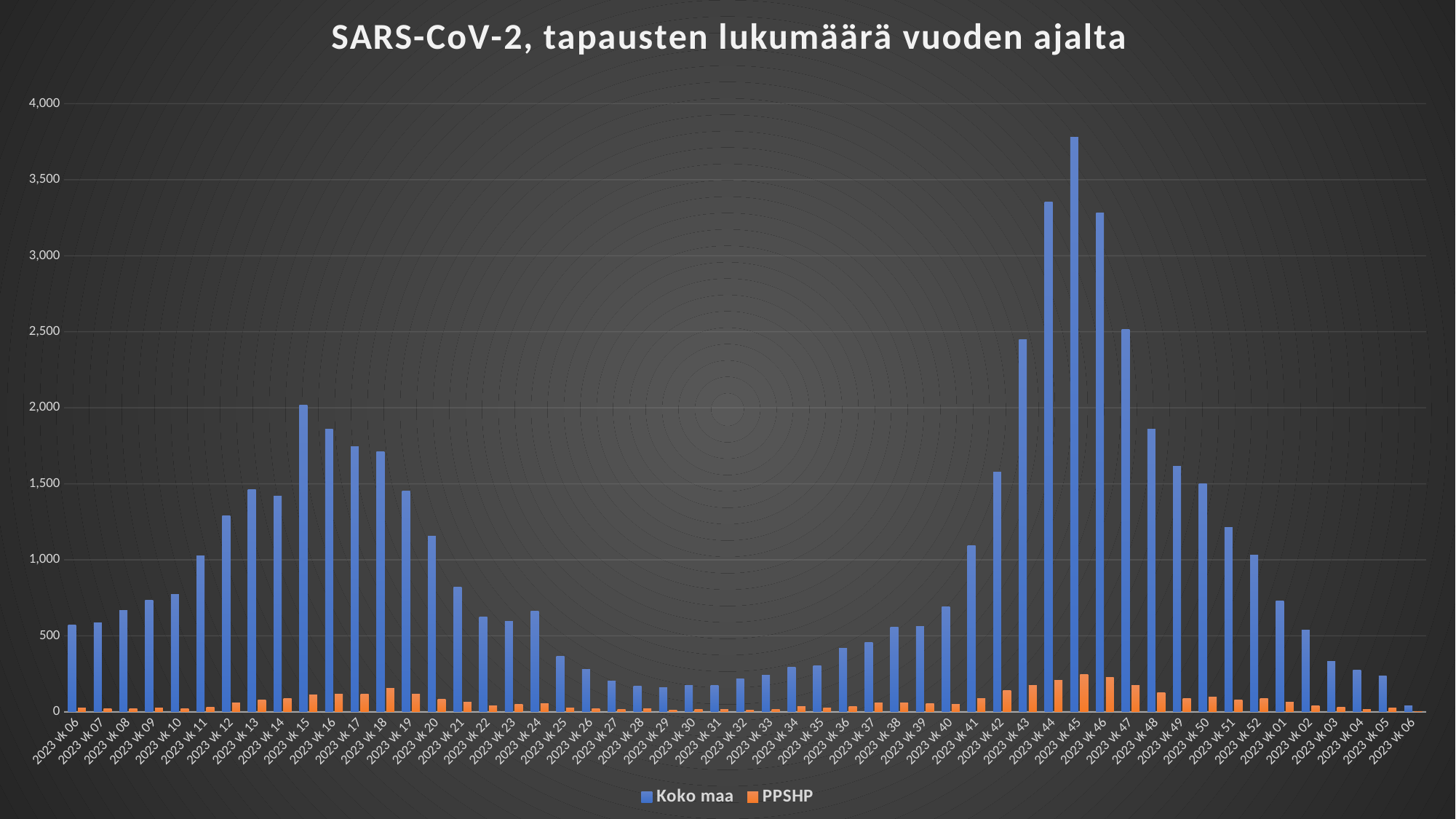
How many series does the legend list? 2 Which week has the highest value for Koko maa? 2023 vk 45 Do the Koko maa values rise or fall from 2023 vk 45 to the last week on the x axis? fall Is the Koko maa value for 2023 vk 48 greater or less than 1,500? greater Is the Koko maa value for 2023 vk 46 greater or less than 3,000? greater Is the Koko maa value for 2023 vk 30 greater or less than 500? less Which is larger for Koko maa: 2023 vk 10 or 2023 vk 20? 2023 vk 20 Which is larger for Koko maa: 2023 vk 15 or 2023 vk 45? 2023 vk 45 Which colour represents the PPSHP series? orange What kind of chart is shown on the slide? bar chart